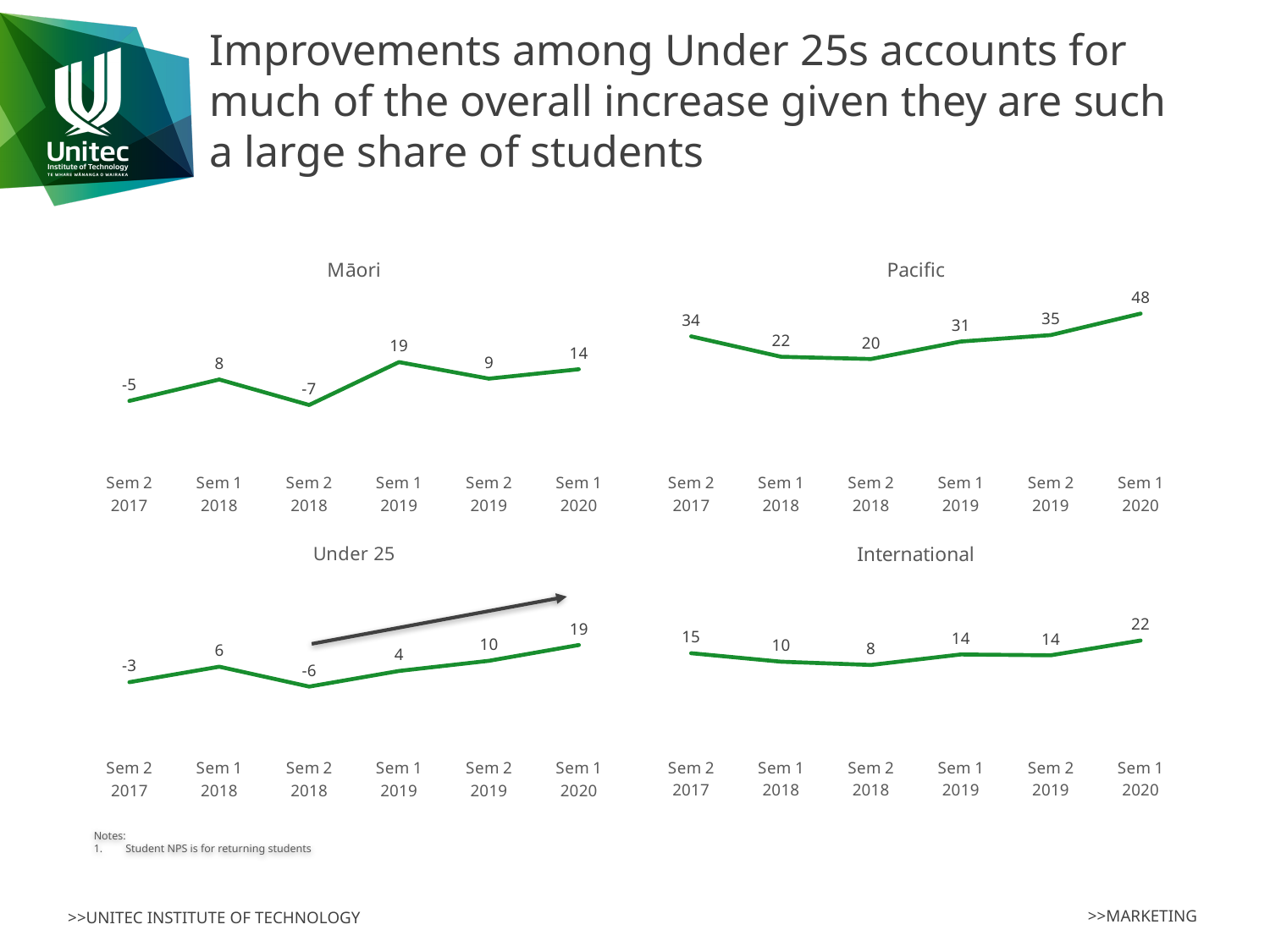
In the Pacific chart, do the values rise or fall from Sem 2 2018 to Sem 1 2020? Rise In the Under 25 chart, what is the difference between the Sem 1 2020 value and the Sem 2 2017 value? 22 In the Pacific chart, what is the difference between the Sem 1 2020 value and the Sem 2 2019 value? 13 In the Under 25 chart, what is the value for Sem 2 2018? -6 In the International chart, what is the value for Sem 1 2018? 10 In the Māori chart, which period has the lowest value? Sem 2 2018 In the Pacific chart, which period has the highest value? Sem 1 2020 How many data points are plotted in the Māori chart? 6 In the Pacific chart, what is the value for Sem 2 2018? 20 What type of chart is the Under 25 chart? Line chart In the International chart, which is larger: the value for Sem 2 2017 or the value for Sem 2 2018? Sem 2 2017 In the Māori chart, what is the value for Sem 1 2020? 14